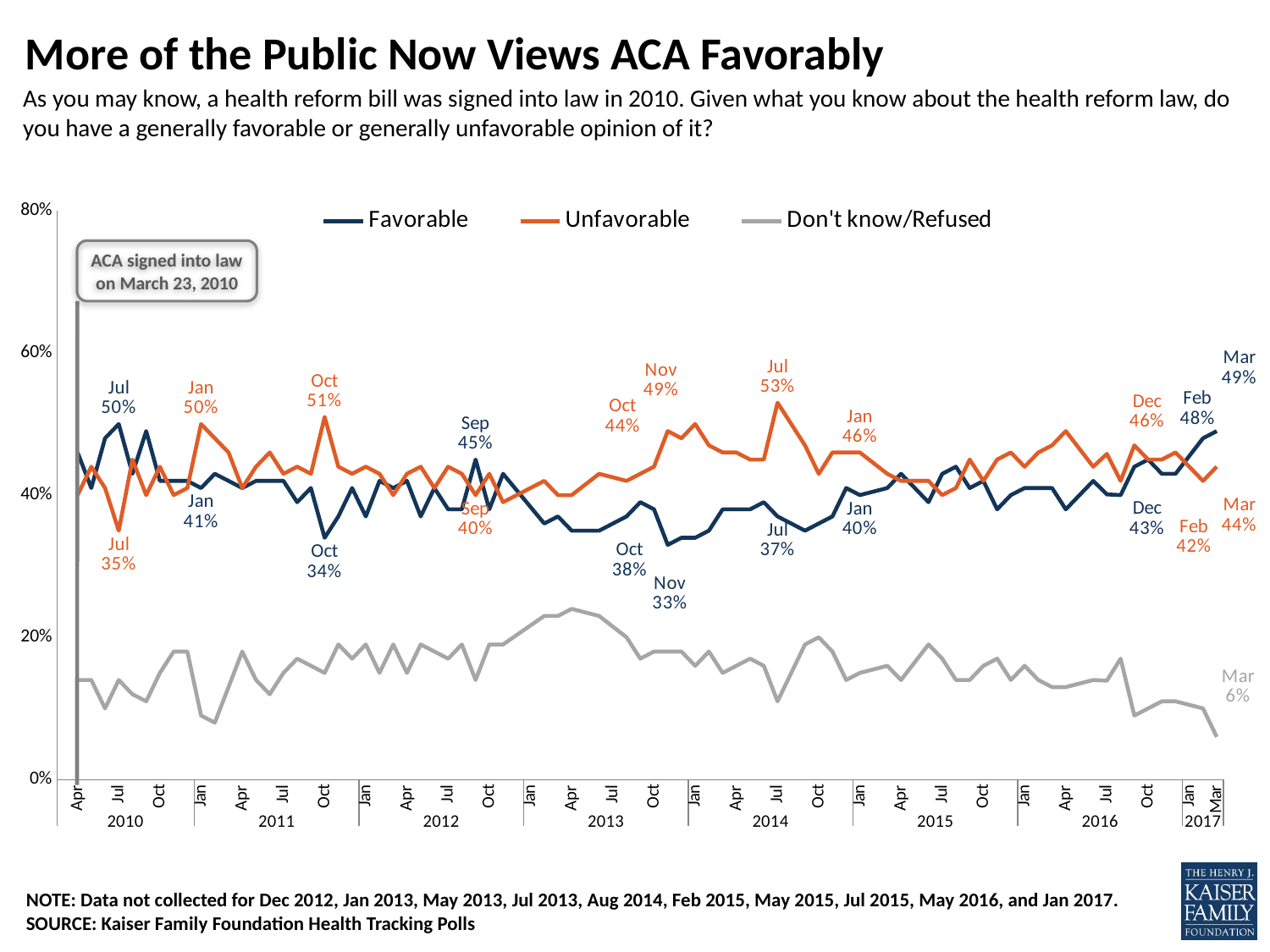
What was the Favorable value in November 2013? 33% What is the difference between the Favorable and Unfavorable values in March 2017? 5 percentage points Is the Don't know/Refused value in April 2013 greater or less than 20%? greater What type of chart is shown on the slide? line chart In which labeled month did the Unfavorable line reach its highest value? Jul 2014 In which labeled month did the Favorable line reach its lowest value? Nov 2013 What was the Favorable value in March 2017? 49% In July 2010, which was larger, Favorable or Unfavorable? Favorable What is the title of the chart? More of the Public Now Views ACA Favorably How many series does the legend list? 3 What was the Unfavorable value in July 2014? 53% What was the Don't know/Refused value in March 2017? 6%